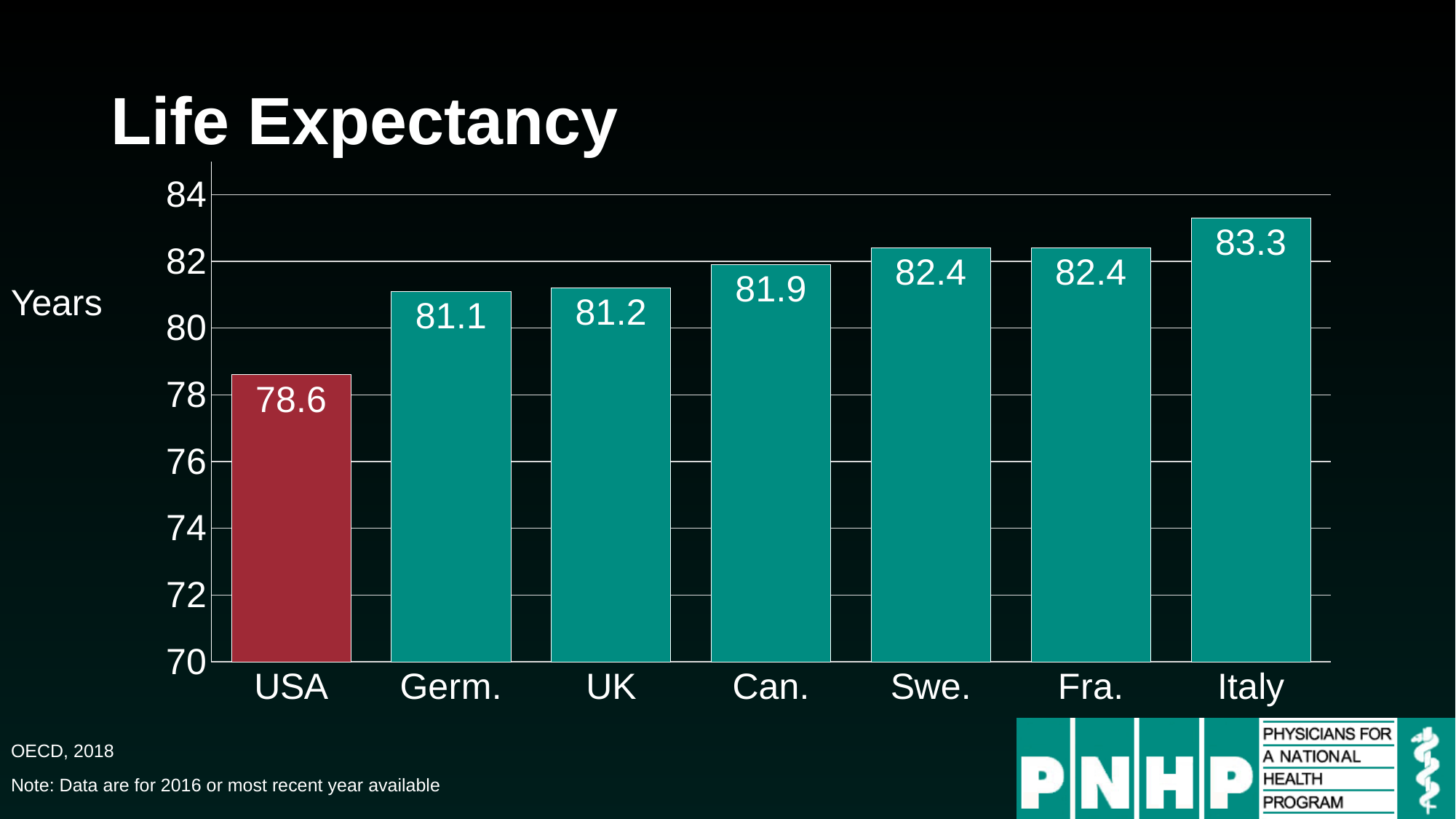
Which bar is coloured differently (red) from the others? USA Which country has the highest life expectancy on the chart? Italy Which country has the lowest life expectancy on the chart? USA What is the life expectancy value shown for the USA? 78.6 What is the life expectancy value shown for Canada (Can.)? 81.9 What is the difference in life expectancy between the UK and Germany (Germ.)? 0.1 What is the life expectancy value shown for Italy? 83.3 Which has a higher life expectancy, Canada (Can.) or the UK? Can. Is the value for the USA greater or less than 80? less What is the difference in life expectancy between Italy and the USA? 4.7 How many countries are shown on the chart? 7 What kind of chart is shown on the slide? bar chart